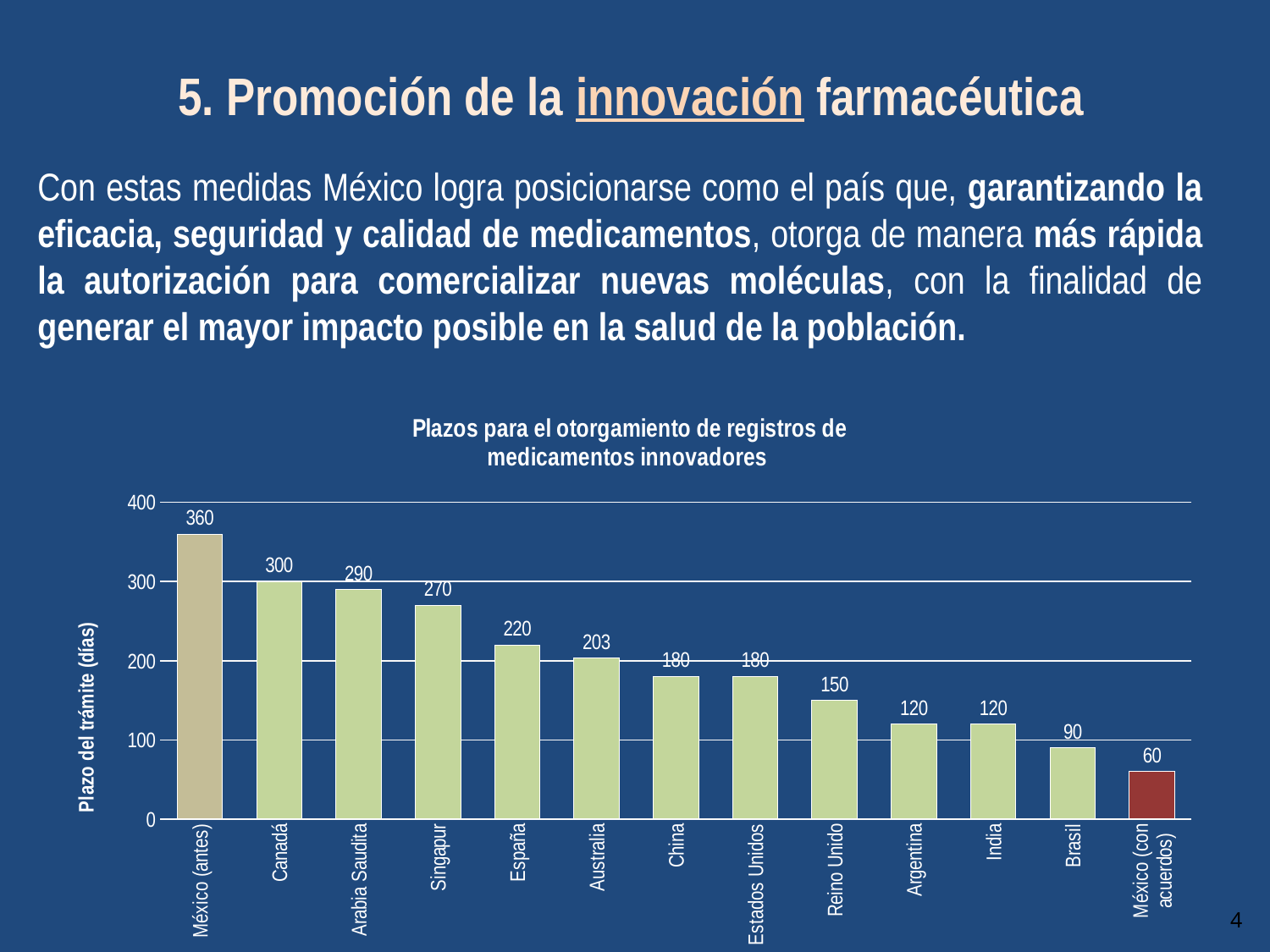
Is the value for Brasil greater or less than 100? less What is the value for Australia? 203 What is the difference between the values for Arabia Saudita and Singapur? 20 Which category has the lowest value? México (con acuerdos) What kind of chart is shown on the slide? bar chart What is the value for México (con acuerdos)? 60 Which is larger, the value for España or the value for Reino Unido? España Which category has the highest value? México (antes) What is the difference between the values for México (antes) and México (con acuerdos)? 300 What is the value for Canadá? 300 What is the label of the y axis? Plazo del trámite (días) How many categories are shown on the x axis? 13